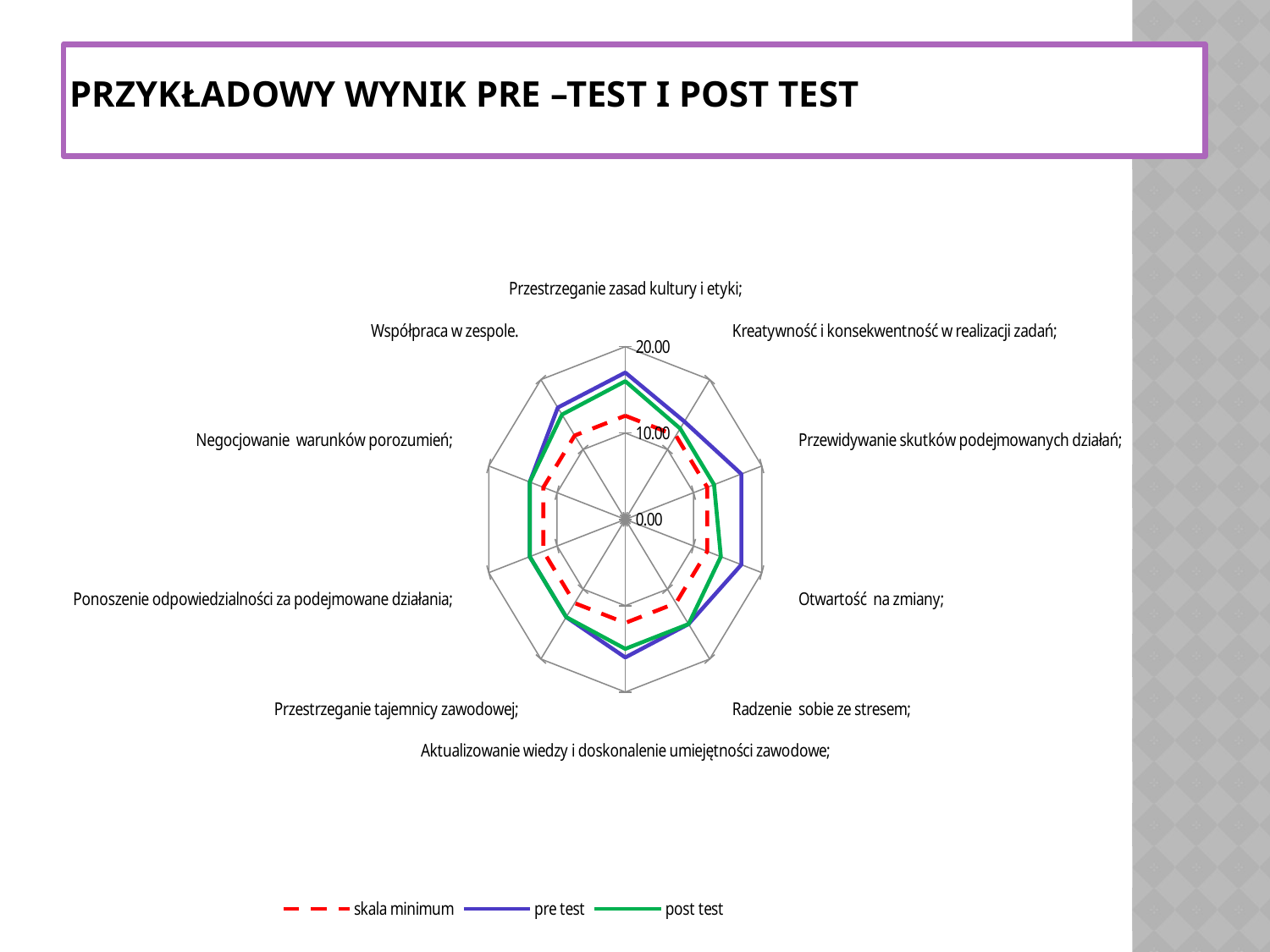
What colour is the line for the post test series? green Which is larger for Przewidywanie skutków podejmowanych działań: the pre test value or the post test value? pre test Is the pre test value for Przestrzeganie zasad kultury i etyki greater or less than 20.00? less What kind of chart is shown on the slide? radar chart Which is larger for Otwartość na zmiany: the post test value or the skala minimum value? post test Is the post test value for Przewidywanie skutków podejmowanych działań greater or less than 10.00? greater Is the pre test value for Przestrzeganie zasad kultury i etyki greater or less than 10.00? greater Which series is drawn with a dashed red line? skala minimum What is the highest value shown on the radar chart's axis scale? 20.00 Which is larger for Przestrzeganie zasad kultury i etyki: the pre test value or the skala minimum value? pre test How many series does the legend list? 3 How many categories (axes) does the radar chart have? 10